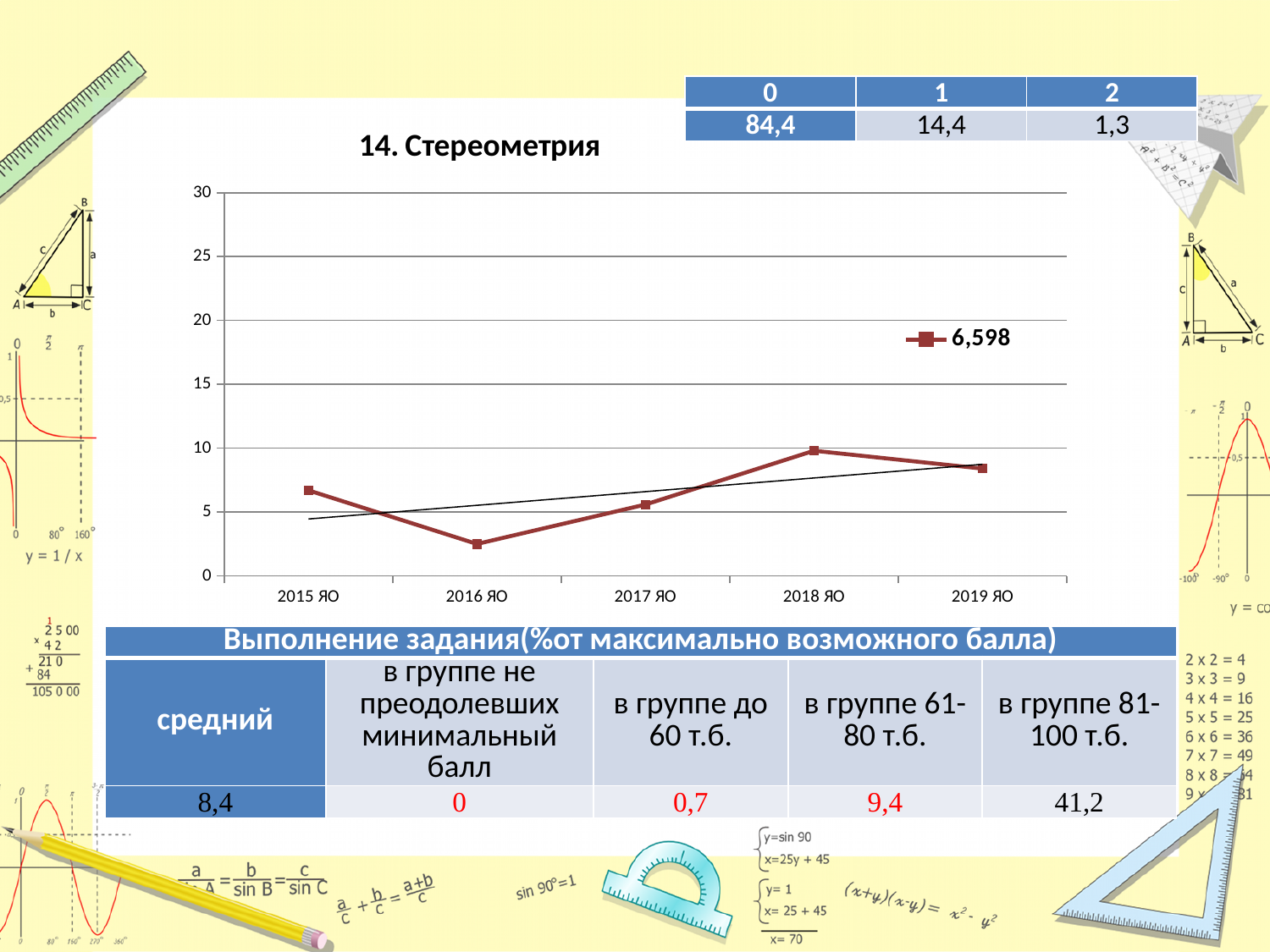
Do the values rise or fall from 2016 ЯО to 2018 ЯО? rise Is the value for 2018 ЯО greater or less than 5? greater Is the value for 2016 ЯО greater or less than 5? less What kind of chart is shown on the slide? line chart How many points are plotted along the x axis of the chart? 5 What is the title of the chart? 14. Стереометрия What is the legend entry shown for the plotted series? 6,598 Which year has the highest value on the chart? 2018 ЯО Which year has the lowest value on the chart? 2016 ЯО Is the value for 2019 ЯО greater or less than 10? less How many series does the chart legend list? 1 Which is larger, the value for 2015 ЯО or the value for 2016 ЯО? 2015 ЯО